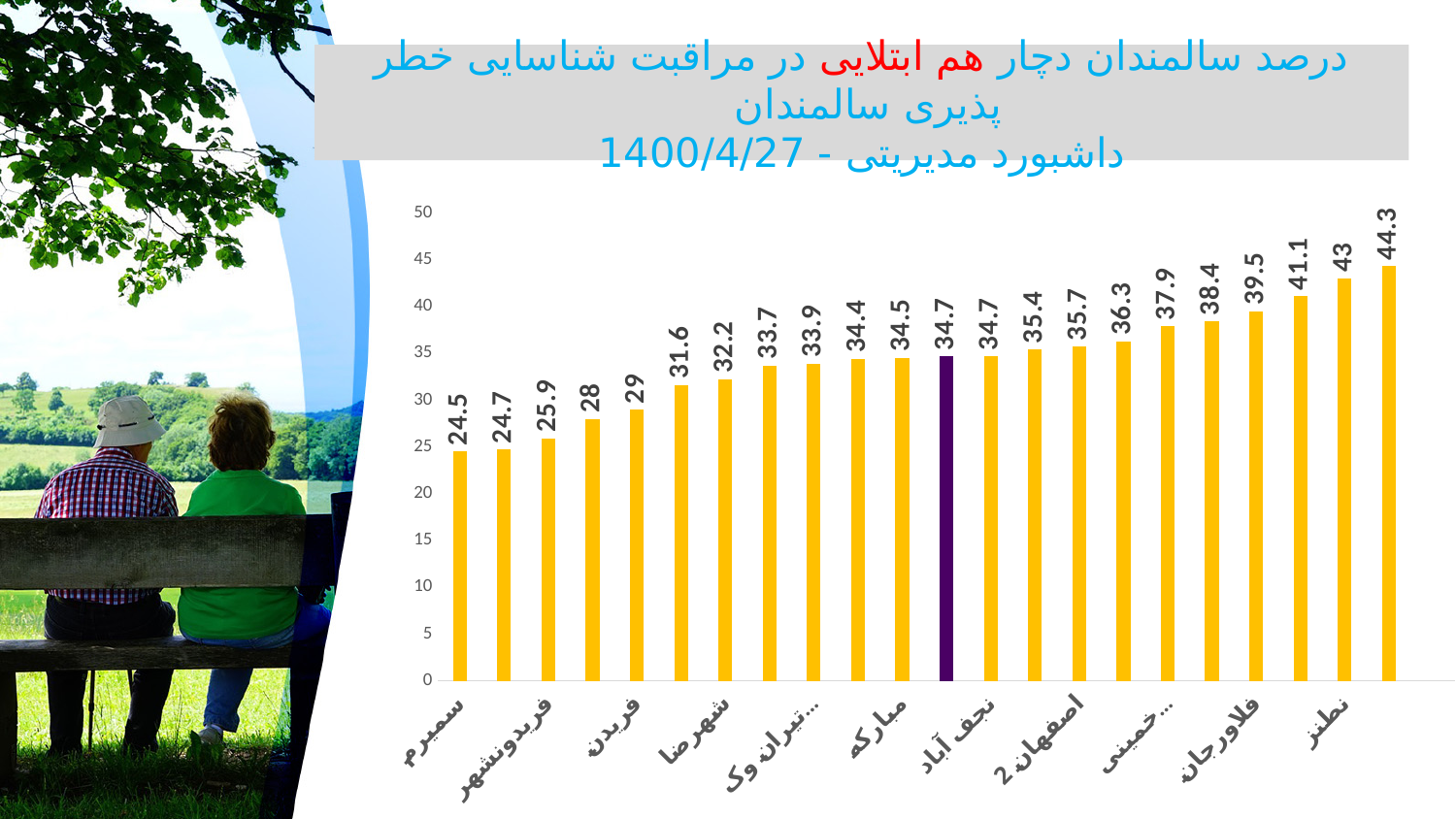
What is the difference between the highest bar (44.3) and the lowest bar (24.5)? 19.8 What is the value of the purple-coloured bar? 34.7 What is the value shown for سمیرم? 24.5 Is the value for سمیرم greater or less than 30? less What is the value of the lowest bar in the chart? 24.5 How many bars are plotted in the chart? 22 What date appears in the chart title? 1400/4/27 What is the value of the highest bar in the chart? 44.3 What kind of chart is shown on the slide? bar chart Do the bar values rise or fall from left to right along the x axis? rise Which category has the lowest value in the chart? سمیرم What is the highest tick value shown on the vertical axis? 50